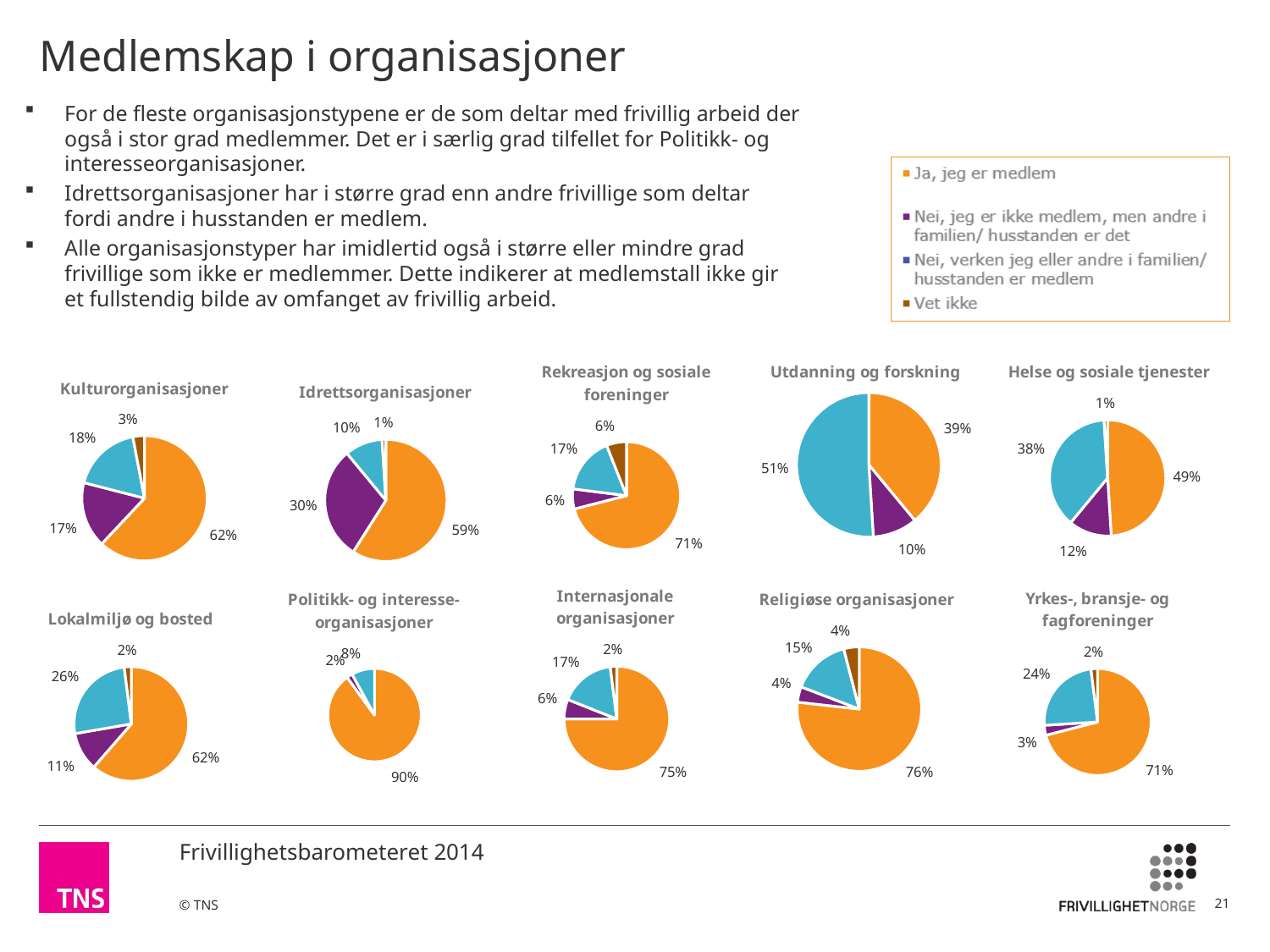
In the Kulturorganisasjoner pie chart, which response has the smallest share? Vet ikke What type of chart is used for Lokalmiljø og bosted? Pie chart In the Politikk- og interesseorganisasjoner pie chart, what share answered "Ja, jeg er medlem"? 90% In the Helse og sosiale tjenester pie chart, what share answered "Nei, verken jeg eller andre i familien/ husstanden er medlem"? 38% In the Idrettsorganisasjoner pie chart, what share answered "Nei, jeg er ikke medlem, men andre i familien/ husstanden er det"? 30% How many response categories does the legend list? 4 In the Utdanning og forskning pie chart, which response has the largest share? Nei, verken jeg eller andre i familien/ husstanden er medlem In the Utdanning og forskning pie chart, what share answered "Ja, jeg er medlem"? 39% In the Yrkes-, bransje- og fagforeninger pie chart, what share answered "Nei, verken jeg eller andre i familien/ husstanden er medlem"? 24% Which chart has the larger "Ja, jeg er medlem" share: Religiøse organisasjoner or Internasjonale organisasjoner? Religiøse organisasjoner How many pie charts are shown on the slide? 10 What is the difference between the "Ja, jeg er medlem" share in the Politikk- og interesseorganisasjoner chart and in the Idrettsorganisasjoner chart? 31 percentage points